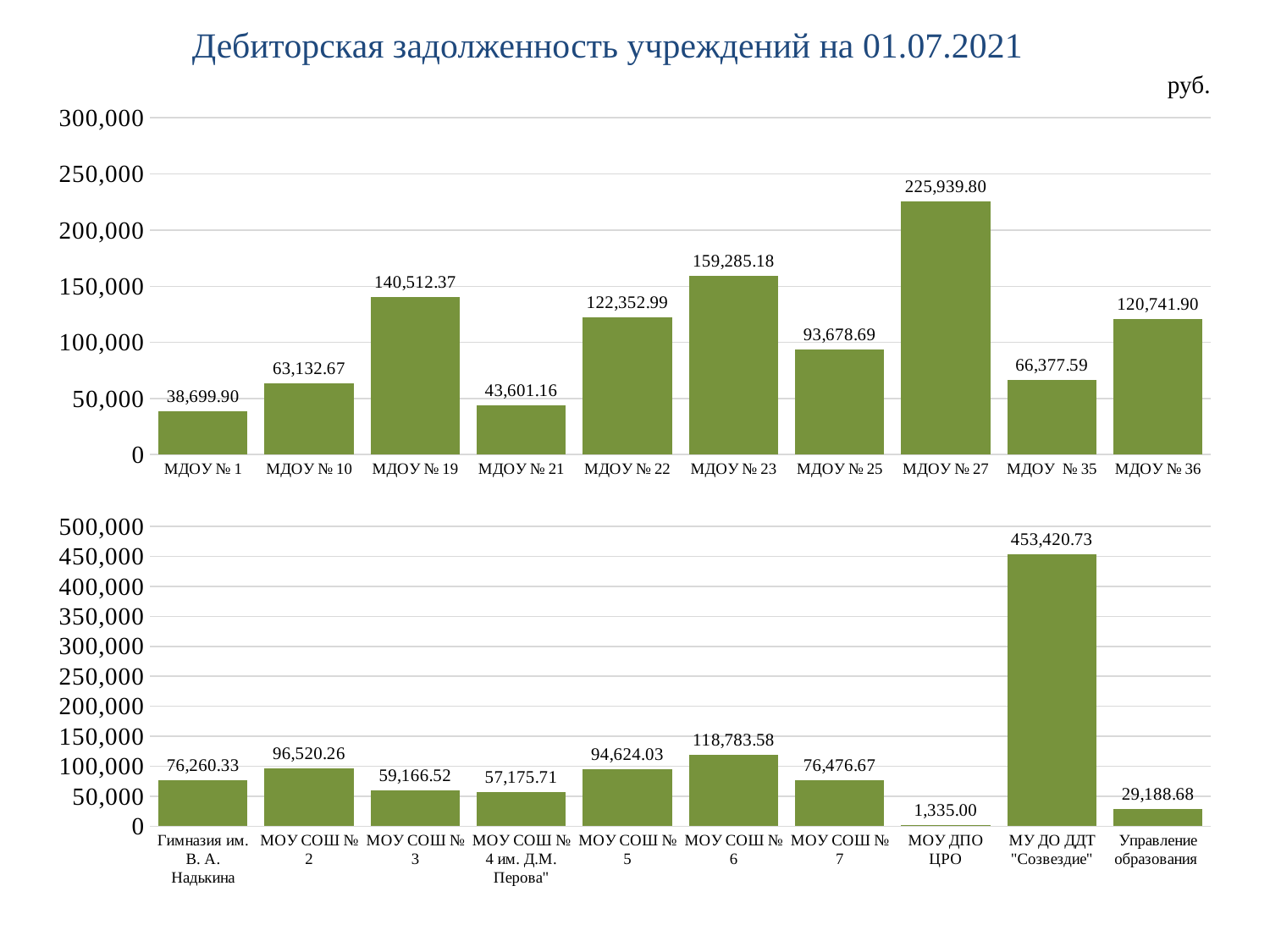
On the bottom chart, what is the value for МОУ ДПО ЦРО? 1,335.00 On the bottom chart, what is the difference between the values for МУ ДО ДДТ "Созвездие" and МОУ ДПО ЦРО? 452,085.73 On the top chart, which category has the lowest value? МДОУ № 1 On the bottom chart, is the value for МОУ СОШ № 6 greater or less than 100,000? greater On the top chart, what is the value for МДОУ № 27? 225,939.80 What kind of chart is the bottom chart? bar chart On the top chart, what is the difference between the values for МДОУ № 27 and МДОУ № 1? 187,239.90 On the bottom chart, which category has the highest value? МУ ДО ДДТ "Созвездие" What is the title shown at the top of the slide? Дебиторская задолженность учреждений на 01.07.2021 On the top chart, how many categories are shown? 10 On the top chart, which is larger: the value for МДОУ № 19 or МДОУ № 22? МДОУ № 19 On the bottom chart, what is the value for Управление образования? 29,188.68